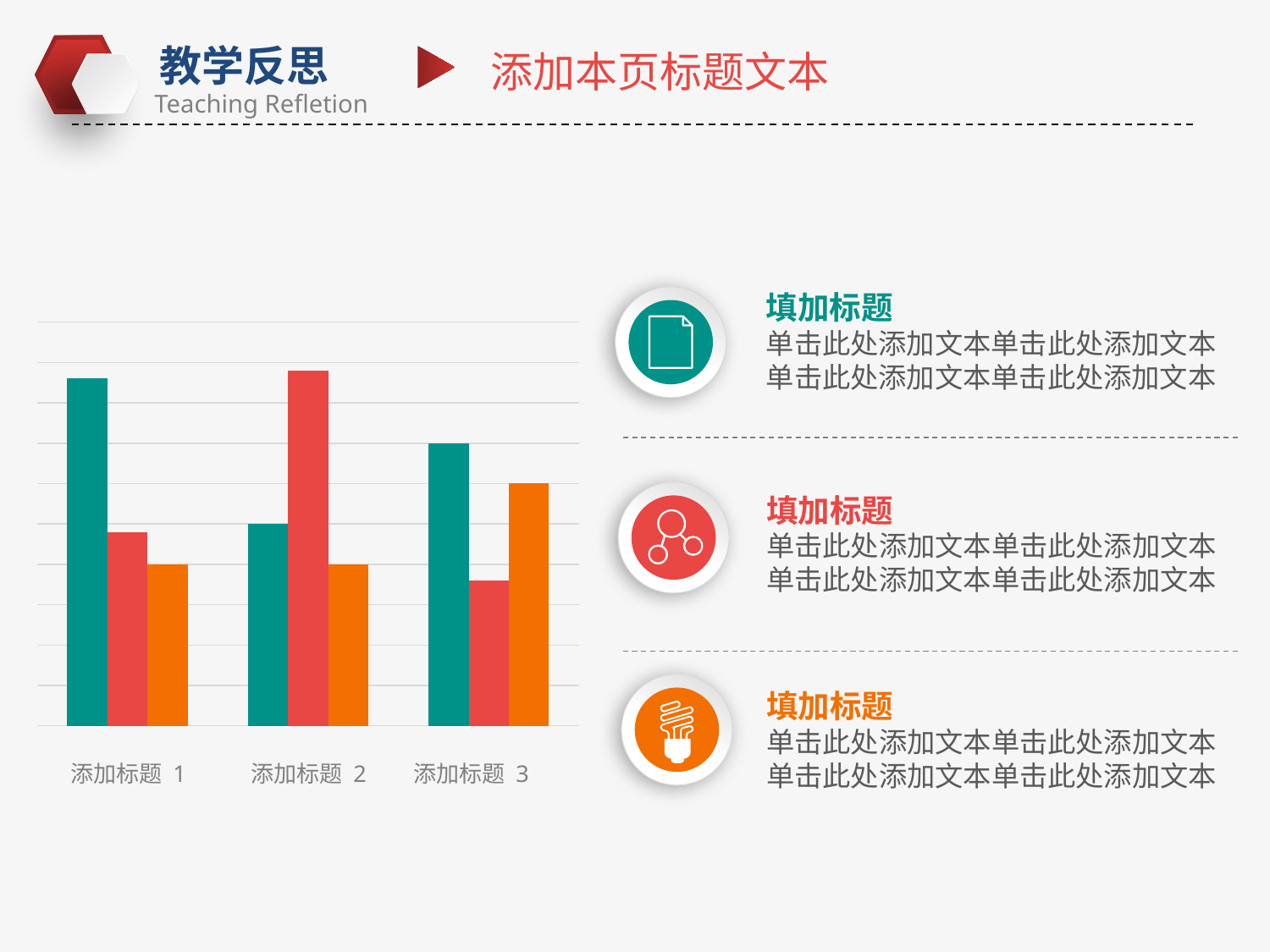
Across the three categories, which category has the shortest red bar? 添加标题 3 Across the three categories, which category has the tallest red bar? 添加标题 2 How many categories are shown along the x axis of the bar chart? 3 In the category 添加标题 1, which bar is the tallest: the teal, red or orange one? teal In the category 添加标题 2, which bar is the tallest: the teal, red or orange one? red In the category 添加标题 3, which bar is the shortest: the teal, red or orange one? red In the category 添加标题 1, is the red bar or the orange bar taller? red Across the three categories, which category has the shortest teal bar? 添加标题 2 How many bars are plotted for each category in the bar chart? 3 What is the label of the first category on the x axis of the bar chart? 添加标题 1 What kind of chart is shown on the left of the slide? bar chart